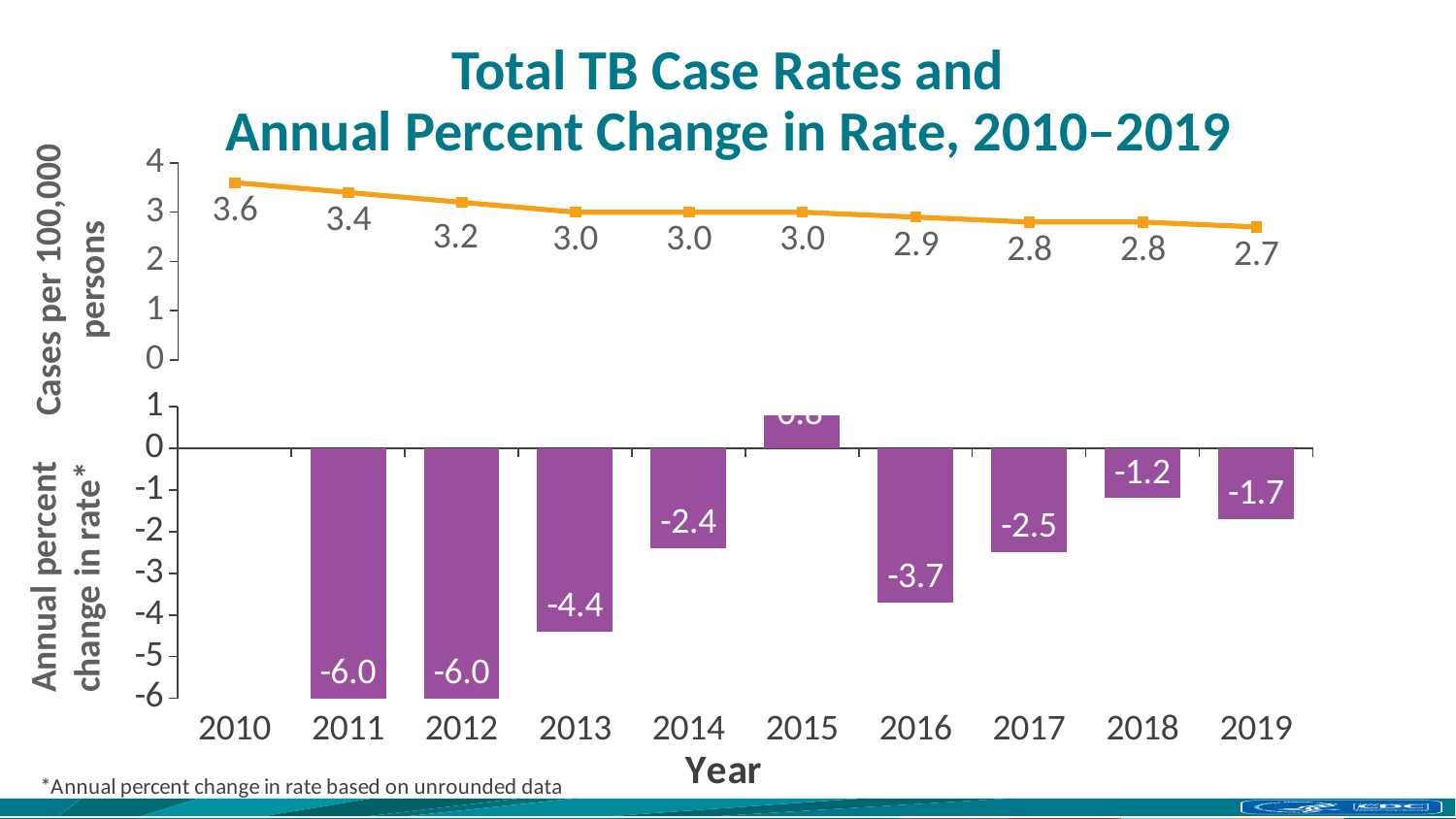
In the bottom bar chart, which years show the largest decrease in rate (the lowest value)? 2011 and 2012 In the bottom bar chart, what is the annual percent change in rate for 2013? -4.4 In the top line chart, what is the difference between the case rate in 2010 and the case rate in 2019? 0.9 In the top line chart, what is the TB case rate per 100,000 persons in 2010? 3.6 In the bottom bar chart, which is larger in magnitude, the percent change in 2014 or in 2017? 2017 What type of chart is the bottom chart showing annual percent change in rate? bar chart In the bottom bar chart, what is the annual percent change in rate for 2016? -3.7 In the top line chart, do the TB case rates generally rise or fall from 2010 to 2019? fall In the top line chart, which year has the lowest TB case rate? 2019 In the top line chart, which year has the highest TB case rate? 2010 In the top line chart, what is the TB case rate per 100,000 persons in 2019? 2.7 How many years are shown on the x axis of the charts? 10